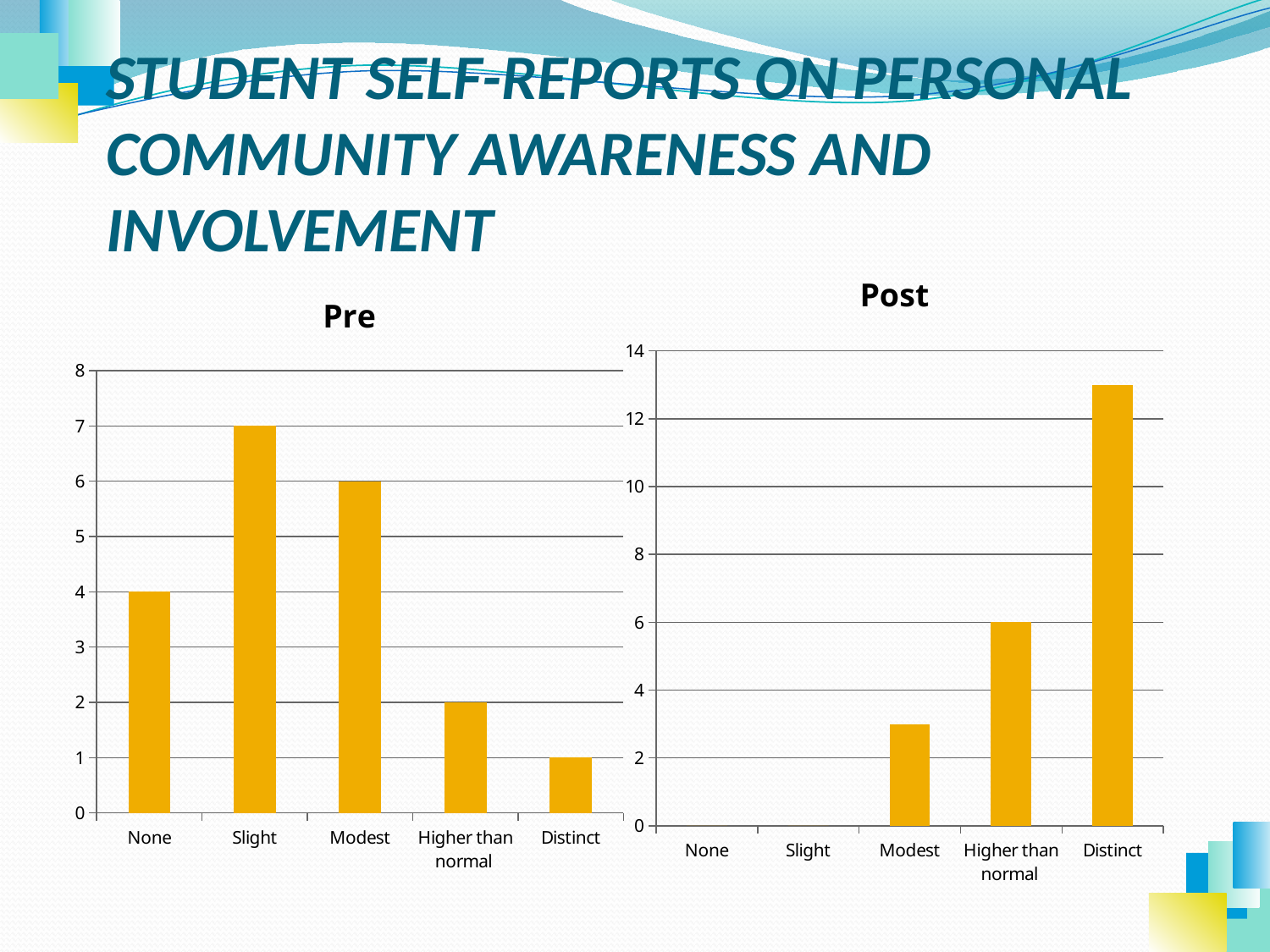
On the Pre chart, what is the value for Slight? 7 On the Post chart, what is the value for Higher than normal? 6 What kind of chart is the Post chart? bar chart On the Post chart, is the value for Distinct greater or less than 12? greater How many categories are shown on the x axis of the Pre chart? 5 On the Pre chart, which category has the highest value? Slight On the Pre chart, which category has the lowest value? Distinct On the Post chart, is the value for Modest greater or less than 4? less On the Post chart, which category has the highest value? Distinct On the Pre chart, what is the difference between the values for Slight and None? 3 On the Pre chart, what is the value for None? 4 On the Pre chart, which is larger, the value for Modest or the value for Higher than normal? Modest